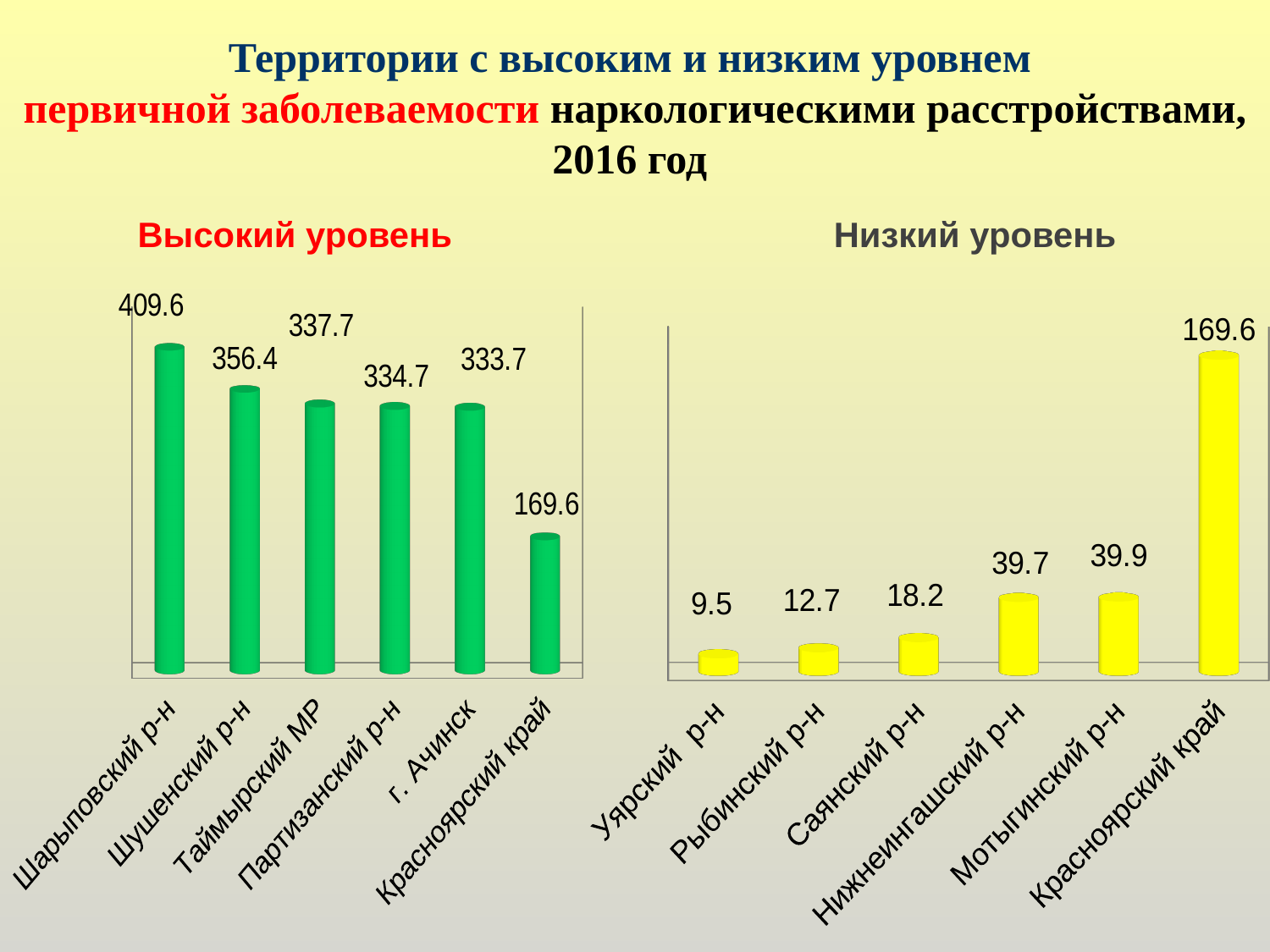
In the 'Высокий уровень' chart, what is the value for г. Ачинск? 333.7 In the 'Низкий уровень' chart, what is the value for Саянский р-н? 18.2 What colour are the bars in the 'Низкий уровень' chart? Yellow In the 'Высокий уровень' chart, what is the value for Шарыповский р-н? 409.6 In the 'Низкий уровень' chart, what is the difference between Красноярский край and Мотыгинский р-н? 129.7 In the 'Высокий уровень' chart, what is the difference between Шарыповский р-н and Шушенский р-н? 53.2 In the 'Высокий уровень' chart, which category has the highest value? Шарыповский р-н What type of chart is the 'Низкий уровень' chart? Bar chart In the 'Низкий уровень' chart, which category has the lowest value? Уярский р-н How many categories are shown in the 'Высокий уровень' chart? 6 In the 'Низкий уровень' chart, which is larger: Рыбинский р-н or Нижнеингашский р-н? Нижнеингашский р-н In the 'Низкий уровень' chart, do the values rise or fall from left to right? Rise